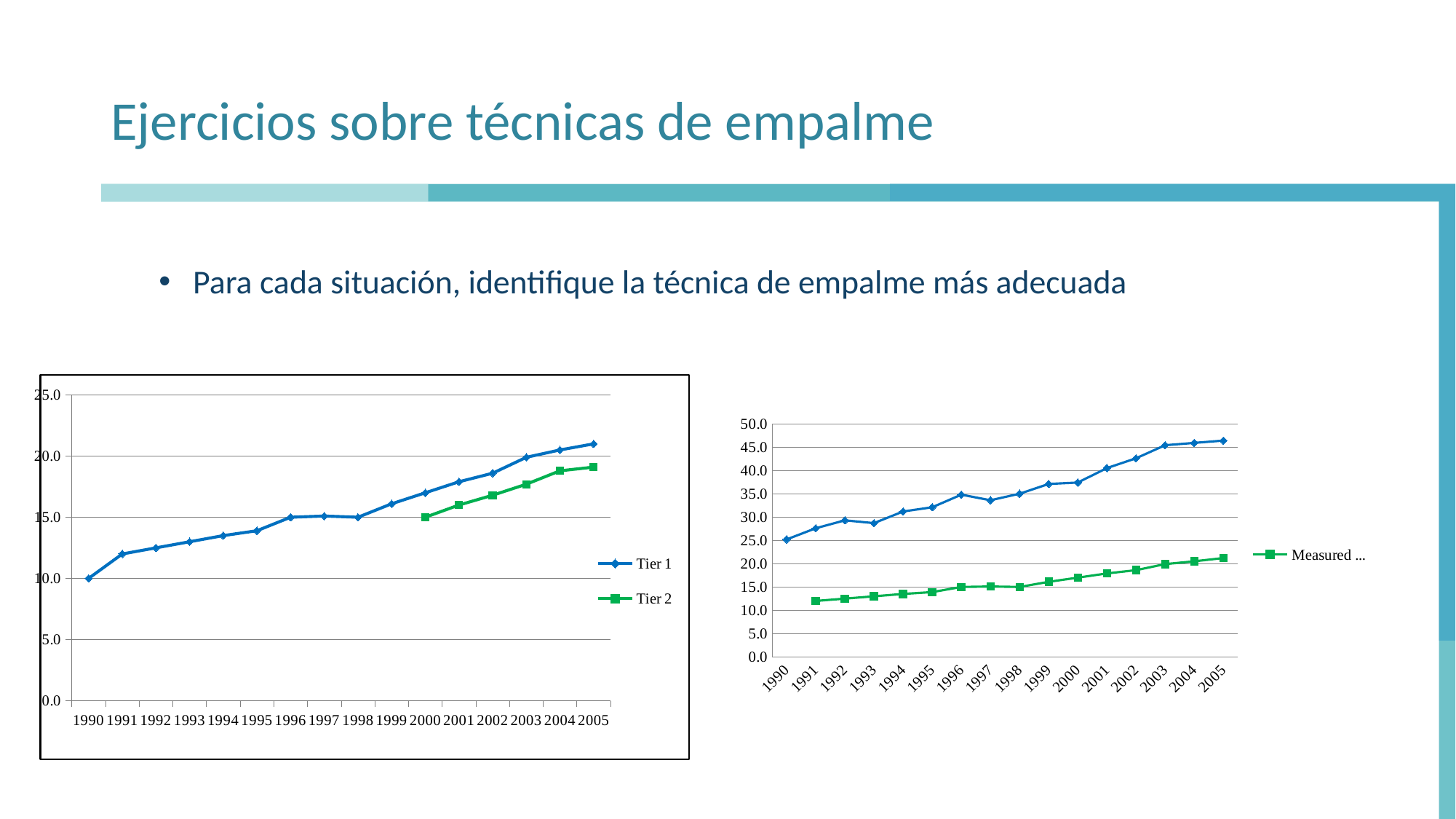
In the left chart, which series has the larger value in 2005, Tier 1 or Tier 2? Tier 1 In the left chart, does Tier 1 generally rise or fall from 1990 to 2005? rise In the left chart, is the value of Tier 2 in 2005 greater or less than 20.0? less What are the legend entries of the left chart? Tier 1, Tier 2 In the right chart, is the value of the blue diamond series in 2005 greater or less than 45.0? greater What kind of chart is the left chart (Tier 1 / Tier 2)? line chart In the left chart, what is the value of Tier 2 in 2000? 15.0 How many years are shown on the x axis of the left chart? 16 In the right chart, is the value of the green square series in 2005 greater or less than 20.0? greater In the left chart, what is the value of Tier 1 in 1990? 10.0 How many series does the legend of the left chart list? 2